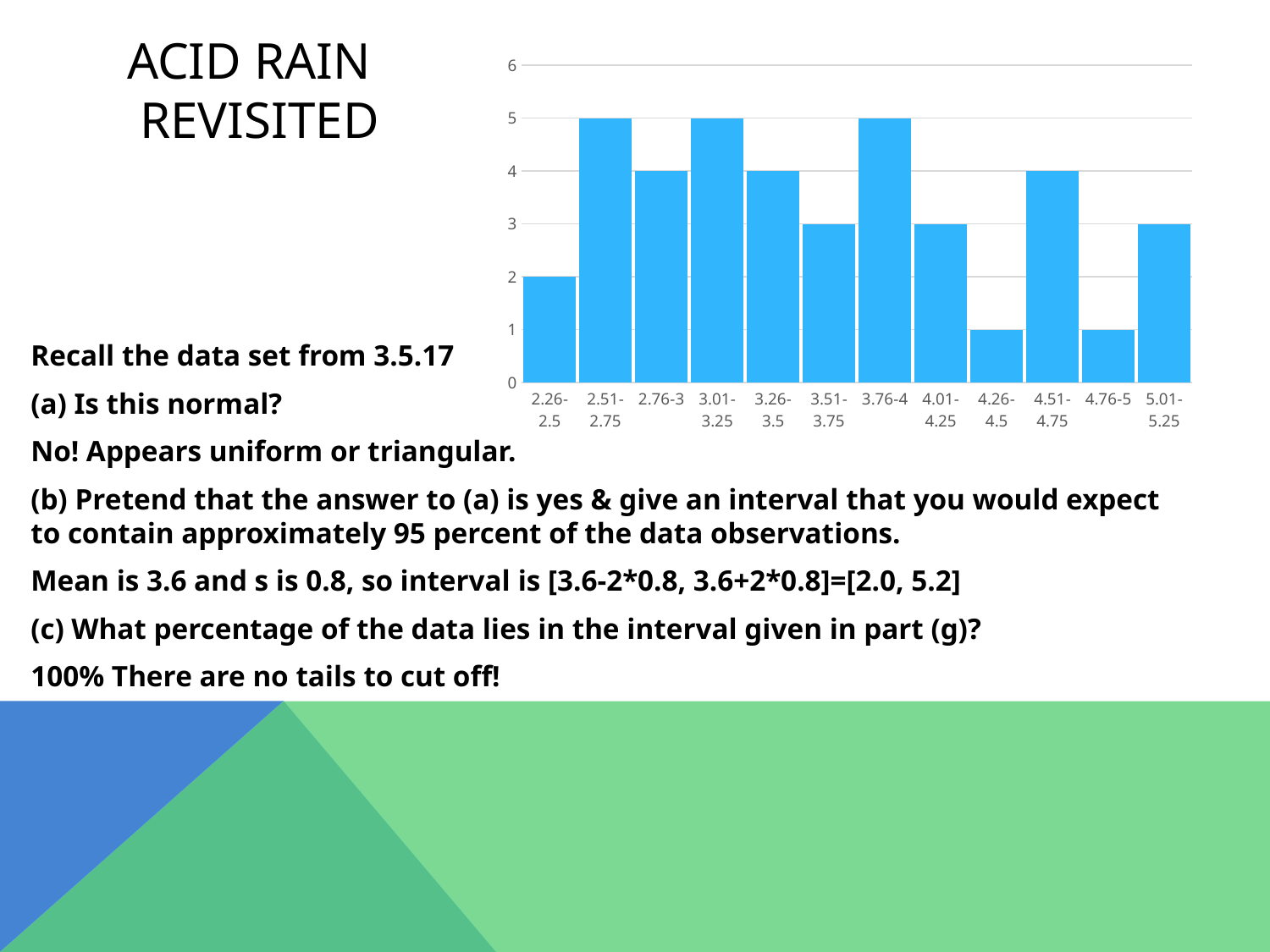
What is the value of the bar for the 4.51-4.75 bin? 4 What is the value of the bar for the 5.01-5.25 bin? 3 What is the value of the bar for the 2.51-2.75 bin? 5 What is the value of the bar for the 2.26-2.5 bin? 2 Which bar is taller: 3.76-4 or 4.01-4.25? 3.76-4 What is the highest value shown on the vertical axis of the chart? 6 Is the value for the 2.76-3 bin greater or less than 3? greater What type of chart is shown on the slide? bar chart What colour are the bars in the chart? blue What is the value of the bar for the 4.26-4.5 bin? 1 How many bins (categories) are shown on the x axis of the chart? 12 What is the difference between the values for the 3.01-3.25 bin and the 4.76-5 bin? 4